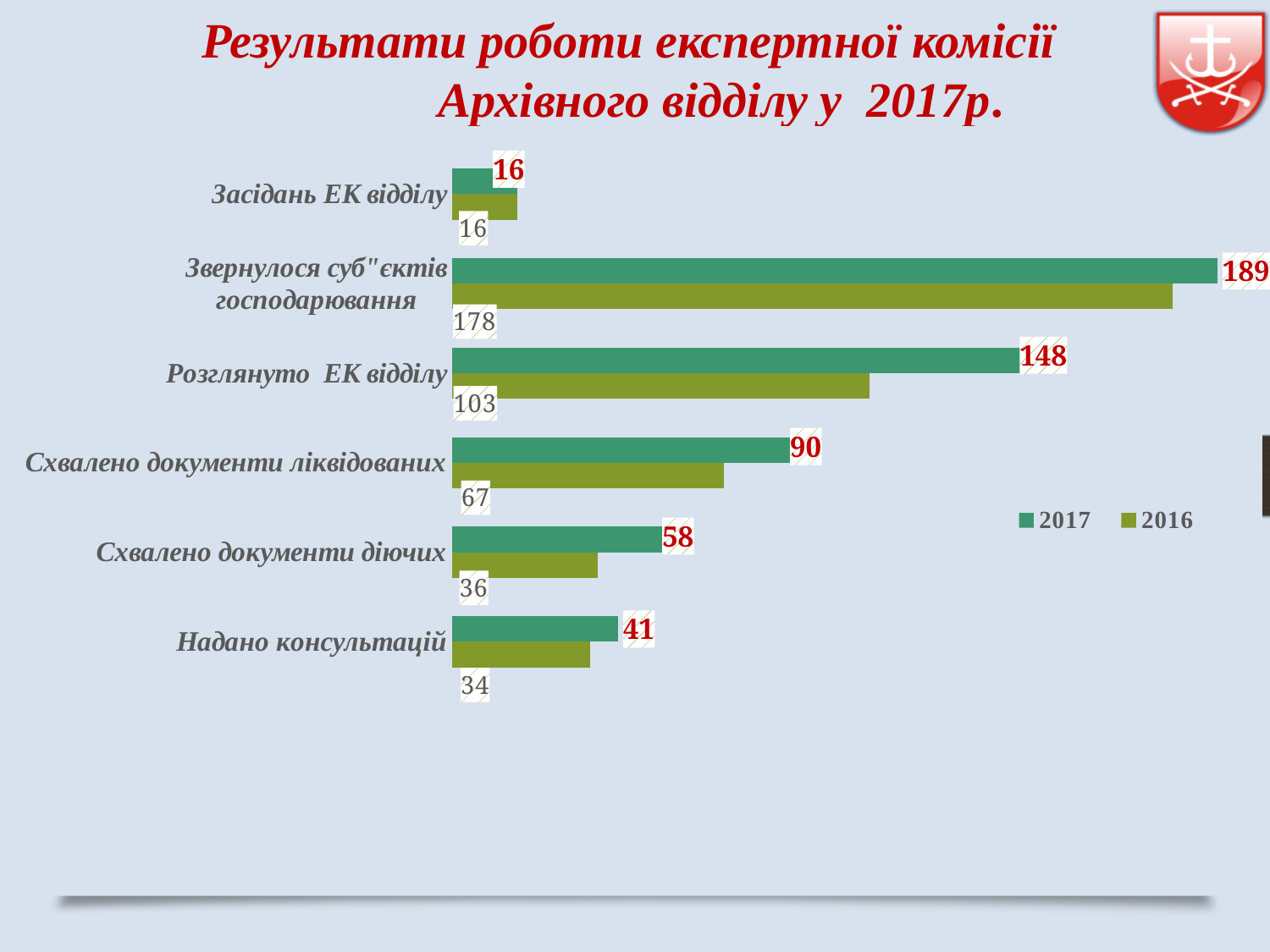
What is the 2017 value for "Схвалено документи діючих"? 58 What is the difference between the 2017 and 2016 values for "Розглянуто ЕК відділу"? 45 What is the 2016 value for "Розглянуто ЕК відділу"? 103 How many categories are shown on the chart? 6 Which category has the lowest 2016 value? Засідань ЕК відділу How many series does the legend list? 2 Which series is shown in the darker green colour? 2017 Which is larger for "Схвалено документи ліквідованих": the 2017 value or the 2016 value? 2017 What is the 2017 value for "Звернулося суб"єктів господарювання"? 189 What kind of chart is shown on the slide? Bar chart Which category has the highest 2017 value? Звернулося суб"єктів господарювання What is the 2016 value for "Надано консультацій"? 34